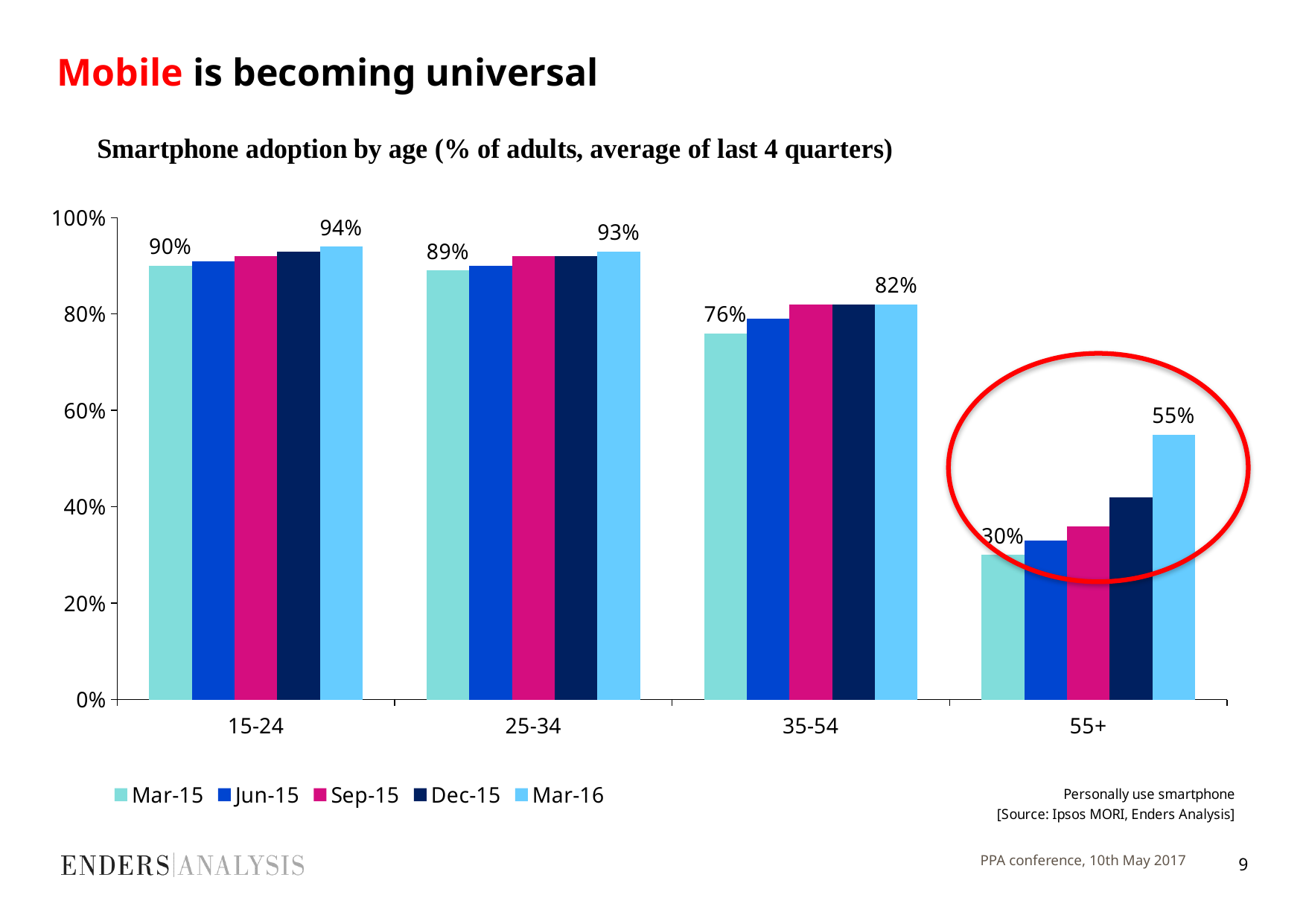
What is the Mar-16 smartphone adoption value for the 15-24 age group? 94% What kind of chart is shown on the slide? Bar chart How many series does the legend list? 5 What is the difference between the Mar-16 and Mar-15 values for the 55+ age group? 25% What is the difference between the Mar-16 values for the 25-34 and 35-54 age groups? 11% Which age group has the lowest Mar-16 smartphone adoption? 55+ Is the Mar-15 value for 25-34 or the Mar-15 value for 35-54 larger? 25-34 Is the Dec-15 value for the 55+ age group greater or less than 60%? less What is the Mar-15 smartphone adoption value for the 55+ age group? 30% Which age group has the highest Mar-16 smartphone adoption? 15-24 How many age groups are shown on the x axis? 4 What is the Mar-16 value for the 35-54 age group? 82%